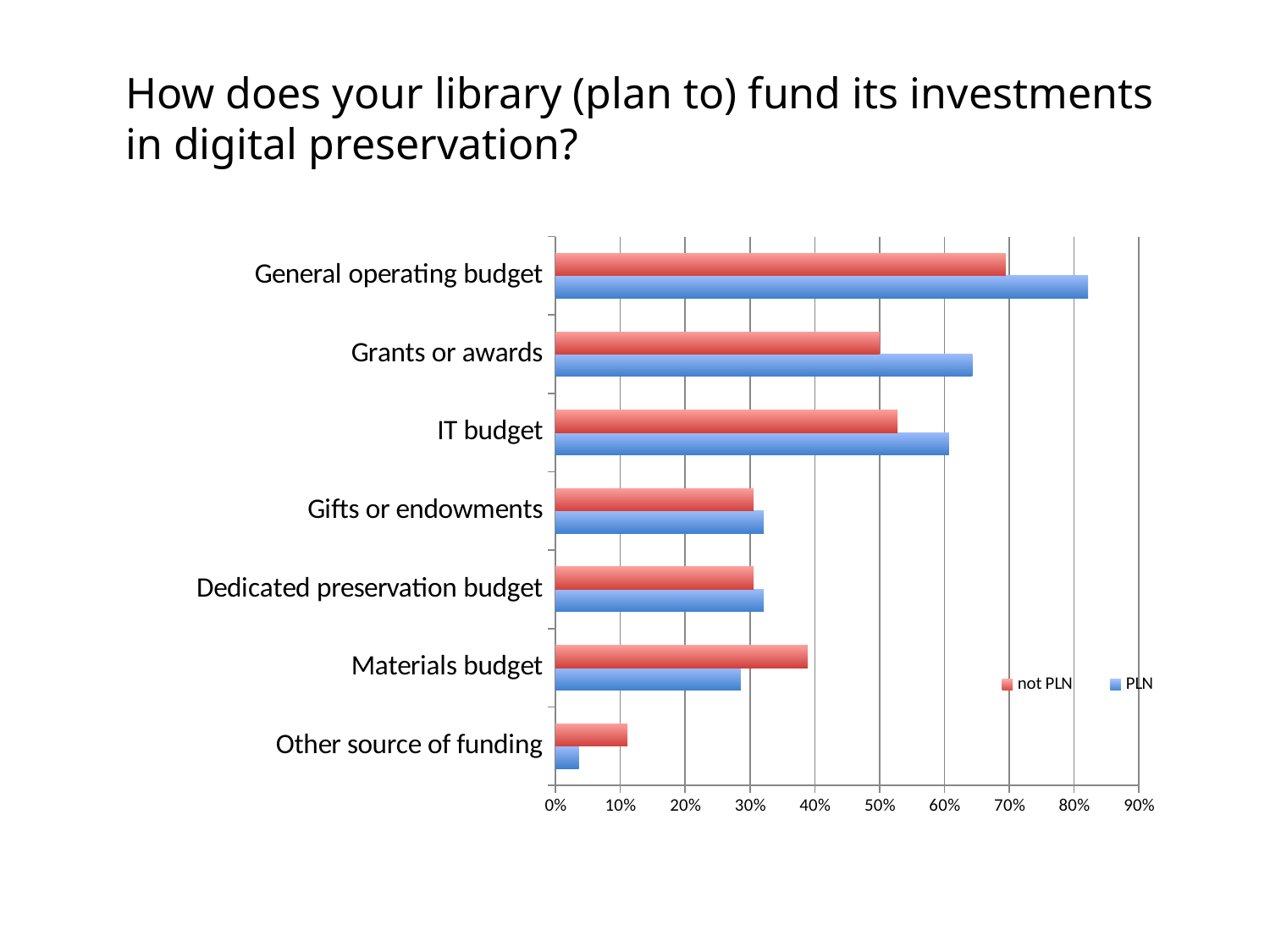
Which series is shown in blue in the legend? PLN How many funding source categories are shown on the chart? 7 Which funding source has the lowest not PLN value? Other source of funding What kind of chart is shown on the slide? bar chart Which funding source has the highest PLN value? General operating budget Is the PLN value for General operating budget greater or less than 80%? greater Is the not PLN value for Grants or awards greater or less than 60%? less Is the not PLN value for Materials budget greater or less than 30%? greater Which funding source has the lowest PLN value? Other source of funding For Materials budget, which series has the larger value, PLN or not PLN? not PLN How many series does the legend list? 2